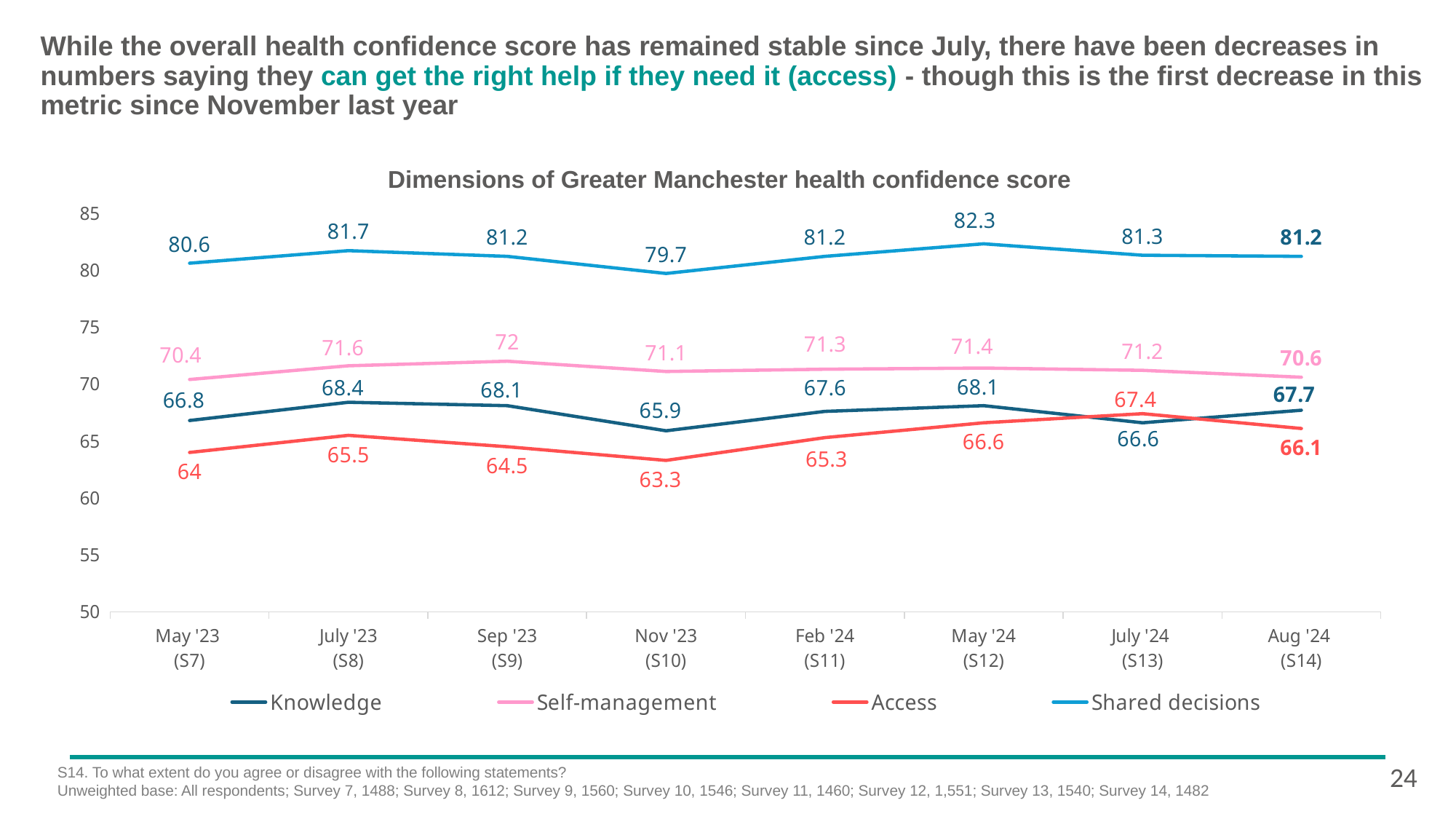
What is the Knowledge value for Aug '24 (S14)? 67.7 What is the Shared decisions value for May '24 (S12)? 82.3 In which survey period is the Shared decisions value highest? May '24 (S12) In which survey period is the Access value lowest? Nov '23 (S10) What is the Access value for Nov '23 (S10)? 63.3 Which is larger in July '24 (S13): the Knowledge value or the Access value? Access How many series does the legend list? 4 What kind of chart is shown on the slide? Line chart What is the difference between the Access values for July '24 (S13) and Aug '24 (S14)? 1.3 How many survey periods are shown on the x axis? 8 What is the title of the chart? Dimensions of Greater Manchester health confidence score What is the Self-management value for Sep '23 (S9)? 72